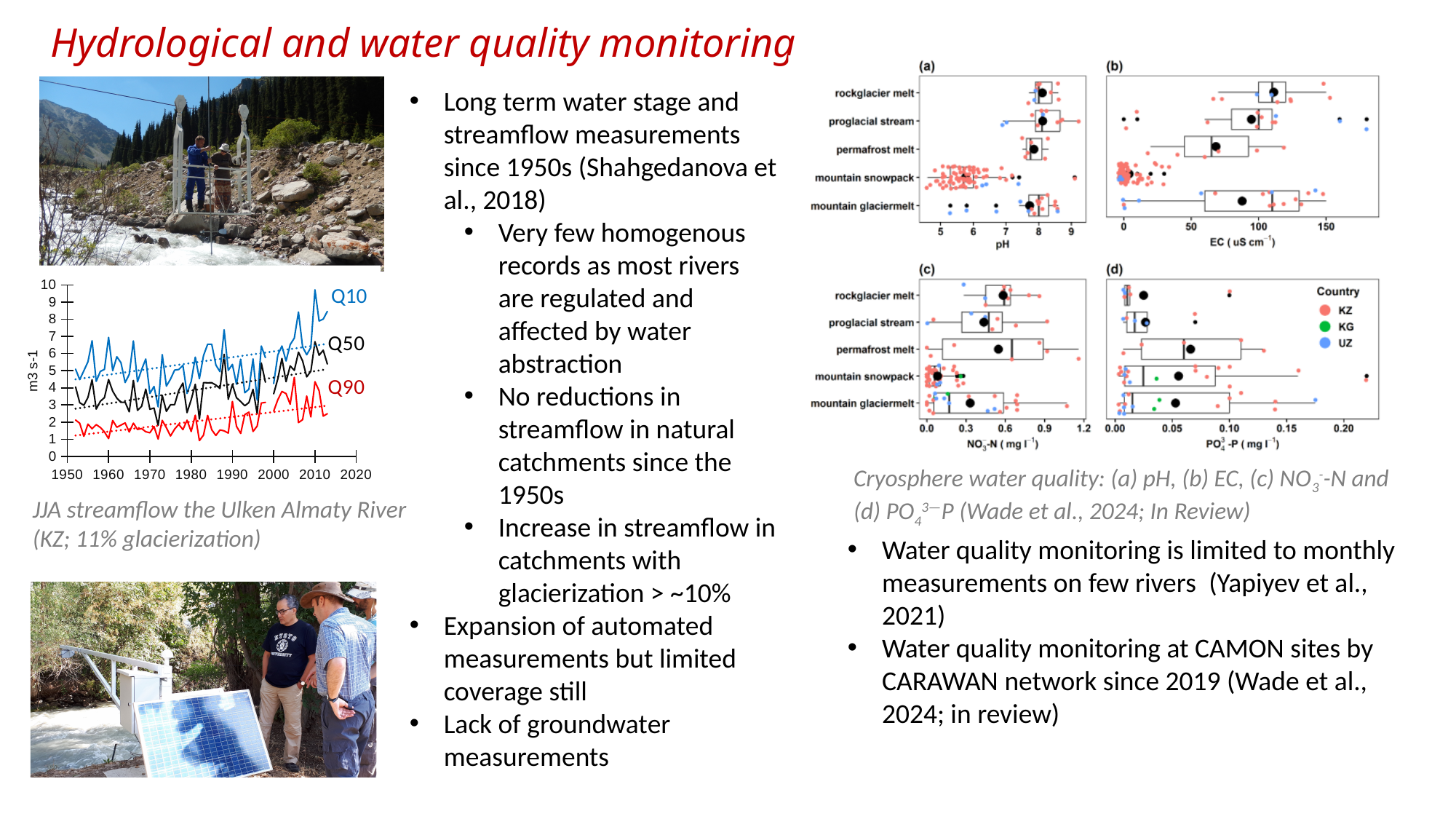
In panel (a) pH of the cryosphere water quality box plots, which category has the lowest median pH? mountain snowpack In the JJA streamflow line chart, is the Q10 value around 2010 greater or less than 6 m3 s-1? greater In the JJA streamflow line chart, which series has the lowest values: Q10, Q50 or Q90? Q90 In the JJA streamflow line chart, is the Q90 value around 1960 greater or less than 3 m3 s-1? less What is the unit shown on the y axis of the JJA streamflow line chart? m3 s-1 What kind of chart is the JJA streamflow chart on the left of the slide? line chart How many series does the JJA streamflow line chart show? 3 How many water source categories are listed on the y axis of each cryosphere water quality box plot panel? 5 In panel (b) EC of the cryosphere water quality box plots, is the median EC for rockglacier melt greater or less than 100 uS cm-1? greater In the JJA streamflow line chart, which series has the highest values: Q10, Q50 or Q90? Q10 How many countries does the legend of the cryosphere water quality box plots list? 3 In the JJA streamflow line chart, do the dotted trend lines rise or fall from 1950 to 2020? rise